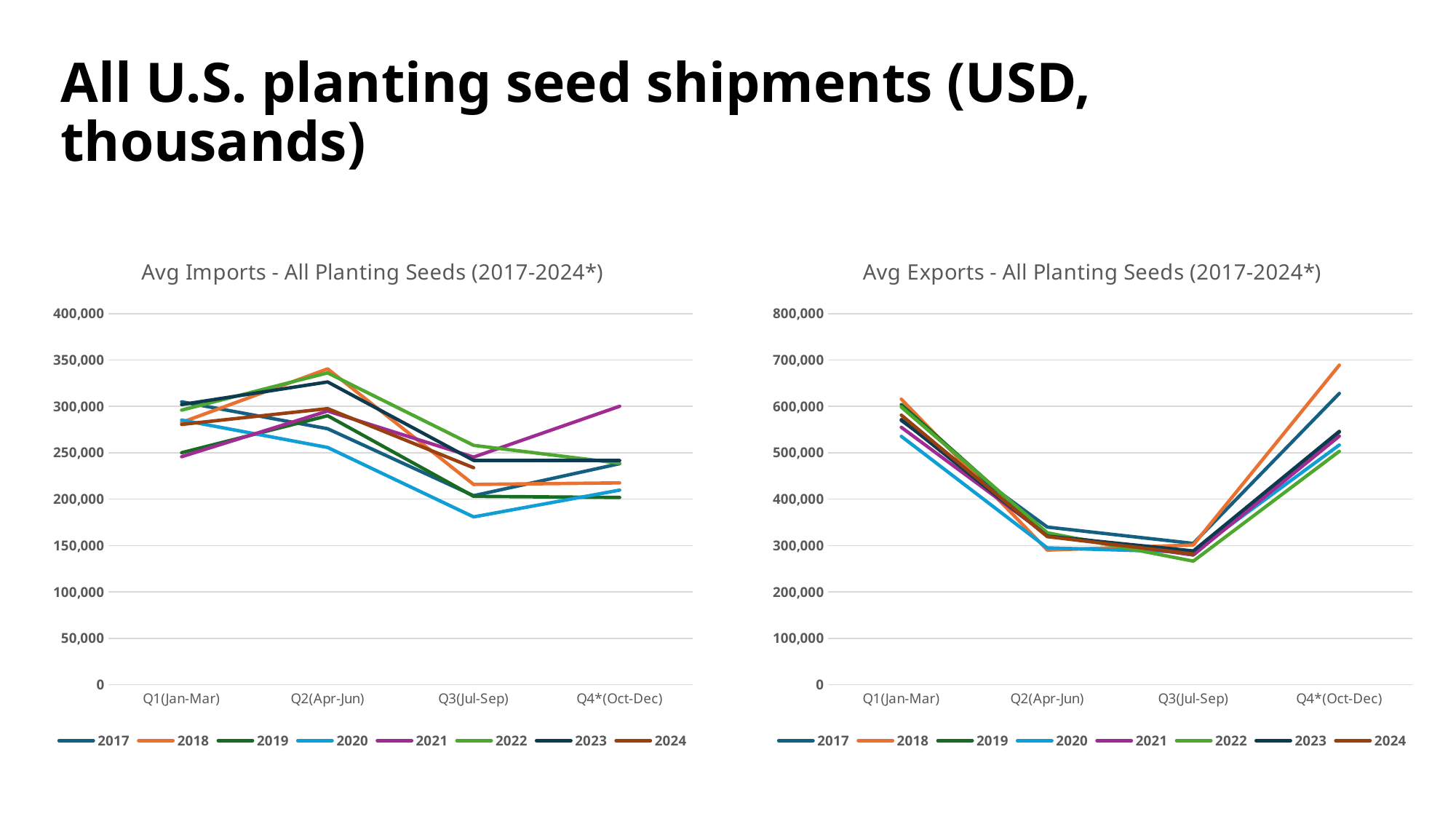
In the Avg Imports chart, is the 2020 value for Q3(Jul-Sep) greater or less than 200,000? less How many series does the legend of the Avg Exports - All Planting Seeds (2017-2024*) chart list? 8 What is the title of the chart on the right side of the slide? Avg Exports - All Planting Seeds (2017-2024*) In the Avg Imports chart, is the 2018 value for Q2(Apr-Jun) greater or less than 300,000? greater In the Avg Imports chart, which year has the lowest value at Q3(Jul-Sep)? 2020 In the Avg Exports chart, is the 2022 value for Q3(Jul-Sep) greater or less than 300,000? less In the Avg Exports chart, which year has the highest value at Q4*(Oct-Dec)? 2018 What kind of chart is the Avg Imports - All Planting Seeds (2017-2024*) chart? line chart How many quarters are shown on the x axis of the Avg Imports - All Planting Seeds (2017-2024*) chart? 4 In the Avg Exports chart, does the 2018 line rise or fall from Q1(Jan-Mar) to Q2(Apr-Jun)? fall In the Avg Exports chart, which is larger at Q4*(Oct-Dec): the 2018 value or the 2017 value? 2018